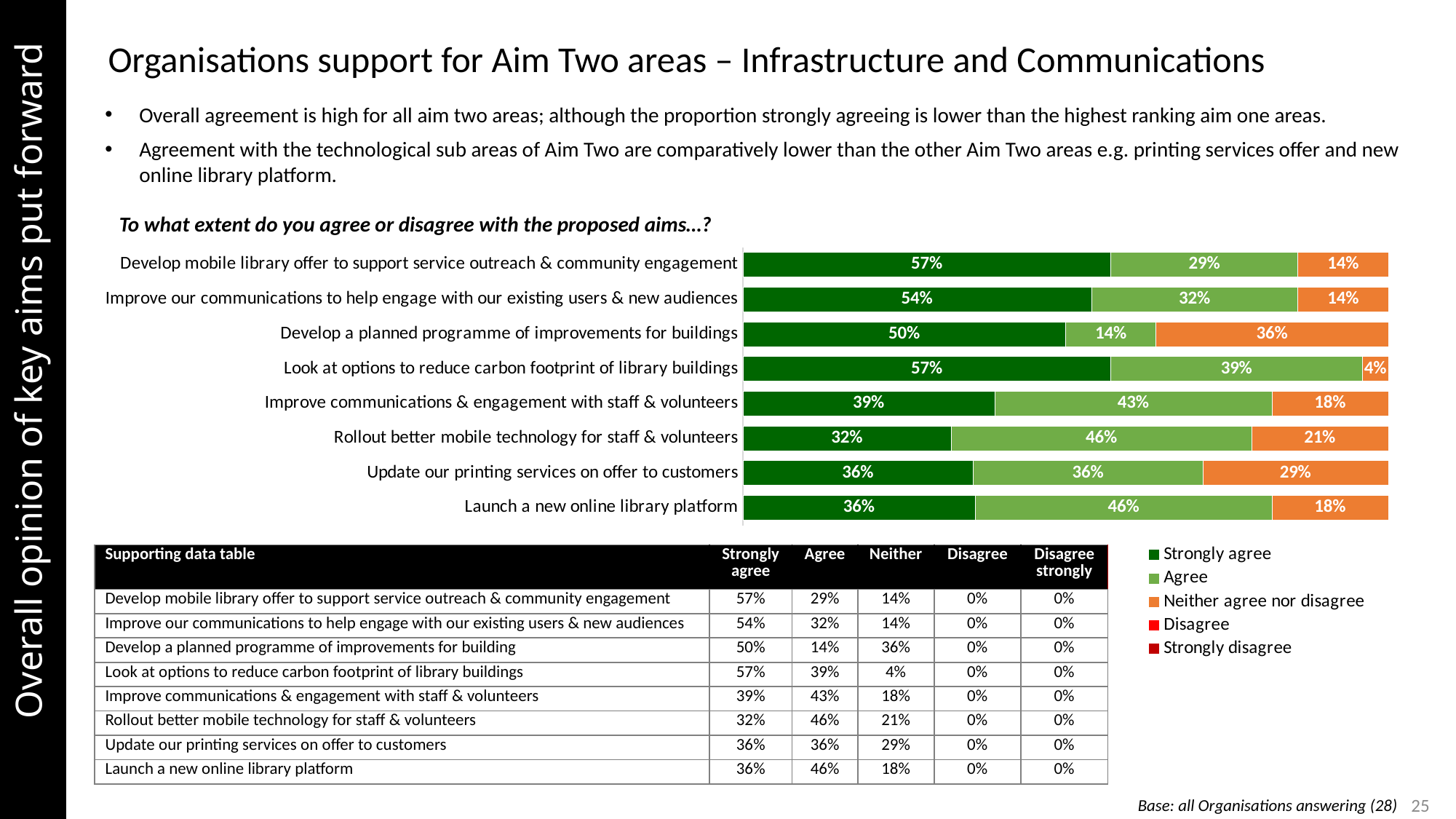
Which has a larger "Agree" share: "Improve communications & engagement with staff & volunteers" or "Improve our communications to help engage with our existing users & new audiences"? Improve communications & engagement with staff & volunteers What is the "Agree" value for "Rollout better mobile technology for staff & volunteers"? 46% Which aim has the lowest "Strongly agree" share? Rollout better mobile technology for staff & volunteers What is the "Neither agree nor disagree" value for "Update our printing services on offer to customers"? 29% How many response categories does the legend list? 5 What percentage of organisations strongly agree with "Develop a planned programme of improvements for buildings"? 50% What kind of chart is used on this slide? Stacked bar chart What is the difference in "Strongly agree" between "Develop mobile library offer to support service outreach & community engagement" and "Launch a new online library platform"? 21 percentage points Which aim has the lowest "Neither agree nor disagree" share? Look at options to reduce carbon footprint of library buildings What colour represents "Neither agree nor disagree" in the chart? Orange How many aims (bars) are shown in the chart? 8 Which aim has the highest "Neither agree nor disagree" share? Develop a planned programme of improvements for buildings